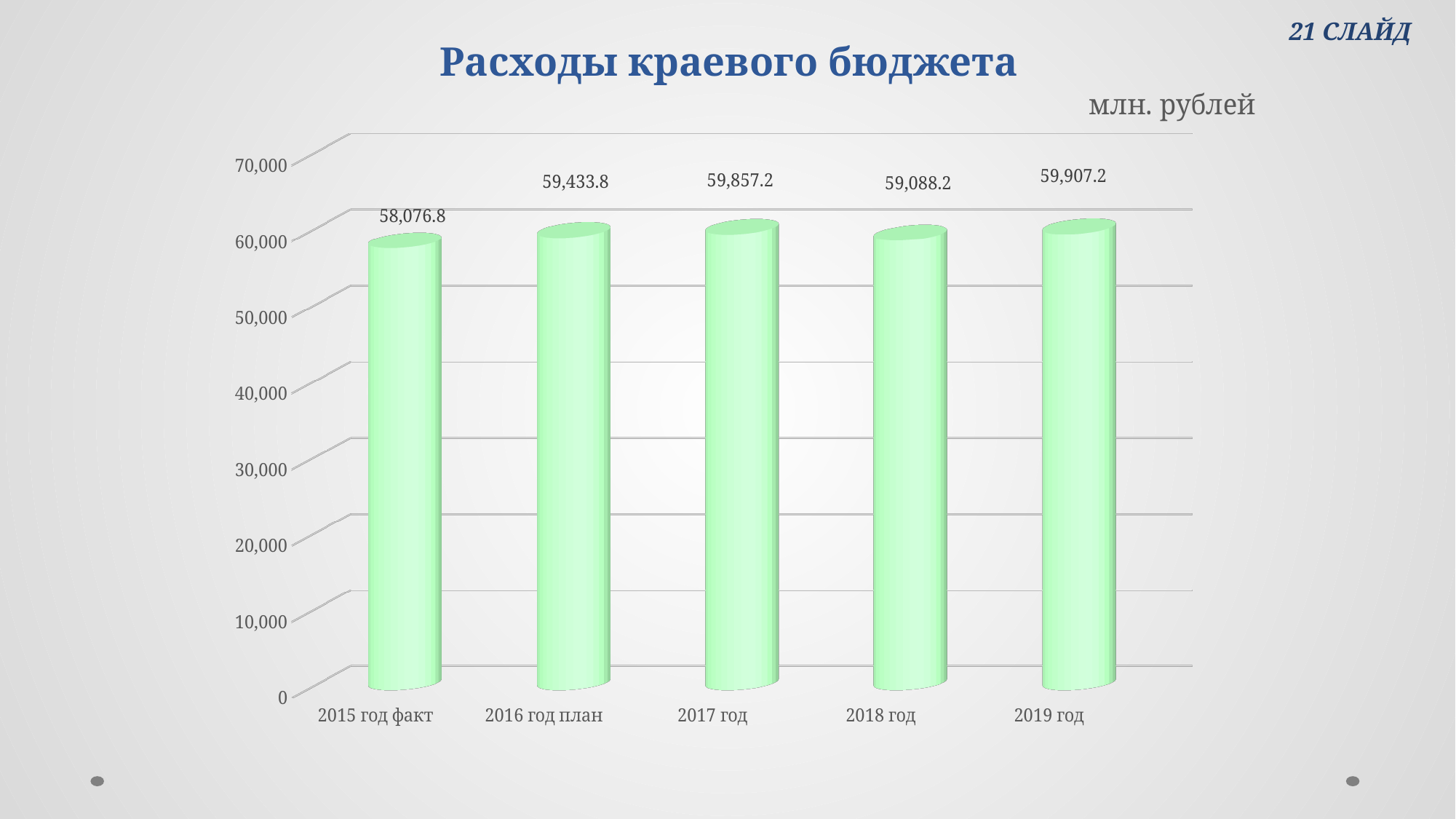
What is the value for 2017 год? 59,857.2 How many categories are shown on the x axis? 5 Which category has the highest value? 2019 год What is the value for 2015 год факт? 58,076.8 What is the difference between the values for 2019 год and 2018 год? 819.0 What unit is indicated for the values in the chart? млн. рублей What is the value for 2019 год? 59,907.2 Which category has the lowest value? 2015 год факт Is the value for 2015 год факт greater or less than 60,000? less What kind of chart is shown on the slide? bar chart What is the difference between the values for 2016 год план and 2015 год факт? 1,357.0 Which is larger, the value for 2017 год or the value for 2018 год? 2017 год